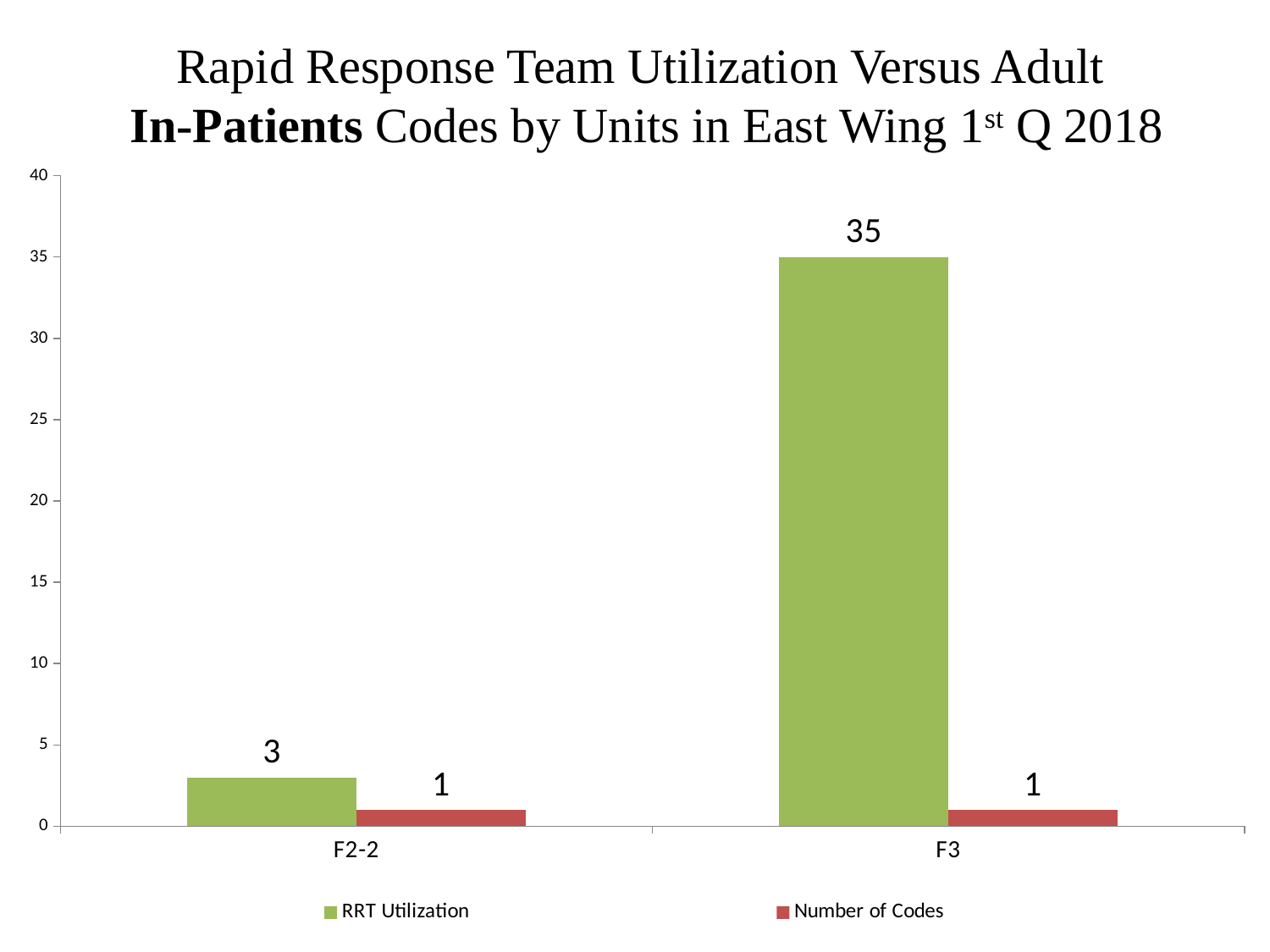
What is the RRT Utilization value for F3? 35 Which unit has the highest RRT Utilization? F3 How many units are shown on the x axis? 2 What is the difference in RRT Utilization between F3 and F2-2? 32 How many series does the legend list? 2 What colour are the RRT Utilization bars? Green What is the Number of Codes for F3? 1 What is the RRT Utilization value for F2-2? 3 Which is larger for F3: RRT Utilization or Number of Codes? RRT Utilization Which unit has the lowest RRT Utilization? F2-2 What is the Number of Codes for F2-2? 1 What kind of chart is shown on the slide? Bar chart